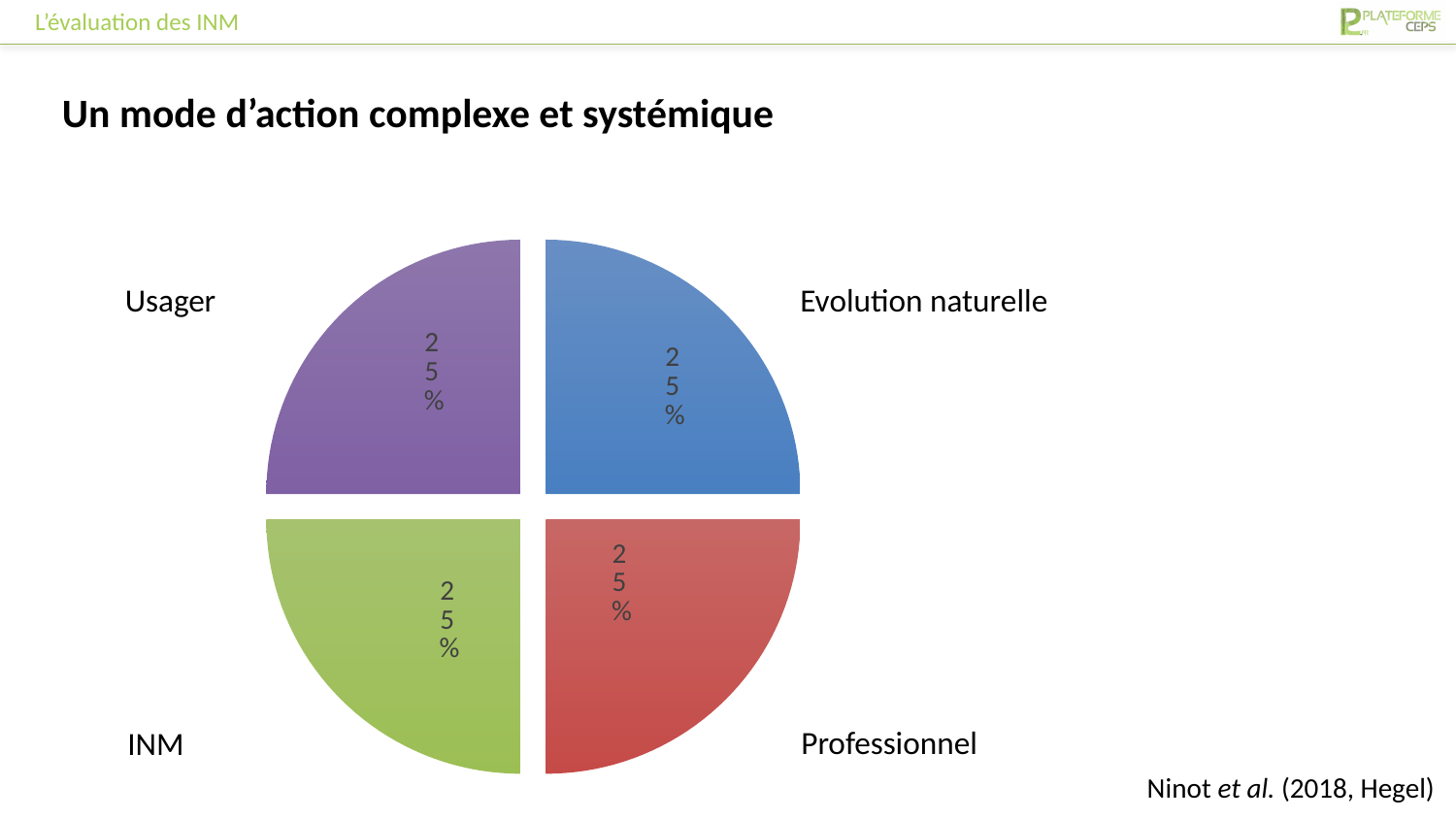
How many slices does the pie chart have? 4 What is the value shown for the Usager slice? 25% Which slice of the pie chart is green? INM What share of the pie does the INM slice represent? 25% What colour is the slice labelled Evolution naturelle? blue What kind of chart is shown on the slide? pie chart What is the difference between the values for Usager and Professionnel? 0% What is the value shown for the Evolution naturelle slice? 25% What is the value shown for the Professionnel slice? 25% What is the value shown for the INM slice? 25% What is the combined value of the Usager and INM slices? 50%